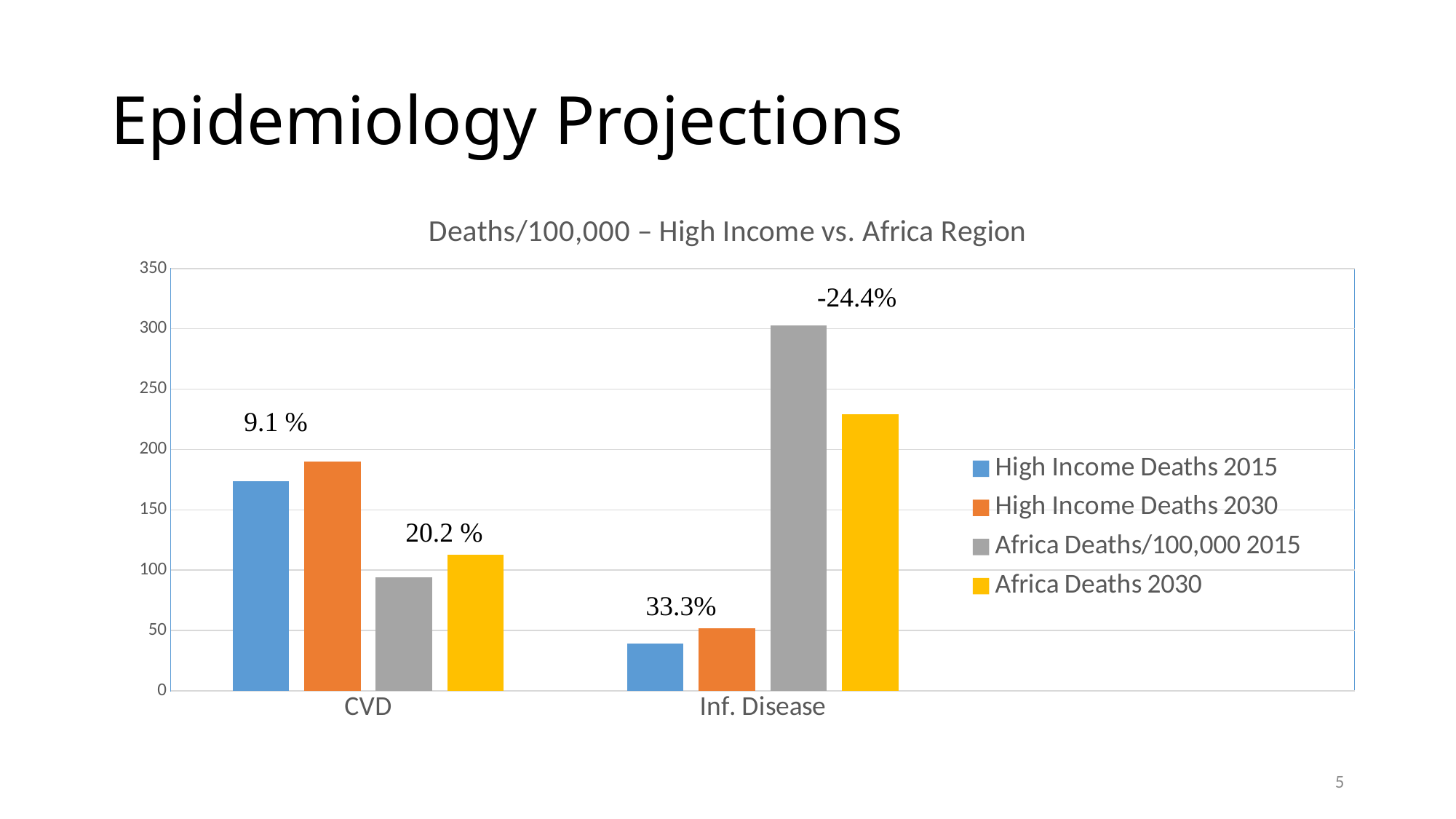
How many categories are shown on the x axis? 2 What kind of chart is shown on the slide? bar chart Is the value for Africa Deaths/100,000 2015 in the Inf. Disease category greater or less than 250? greater Which bar is the tallest in the chart? Africa Deaths/100,000 2015 for Inf. Disease In the CVD category, which is larger: High Income Deaths 2015 or Africa Deaths/100,000 2015? High Income Deaths 2015 How many series does the legend list? 4 What is the title of the chart? Deaths/100,000 – High Income vs. Africa Region Is the value for Africa Deaths 2030 in the Inf. Disease category greater or less than 200? greater Is the value for High Income Deaths 2030 in the CVD category greater or less than 150? greater Within the CVD category, which series has the highest value? High Income Deaths 2030 Which bar is the shortest in the chart? High Income Deaths 2015 for Inf. Disease